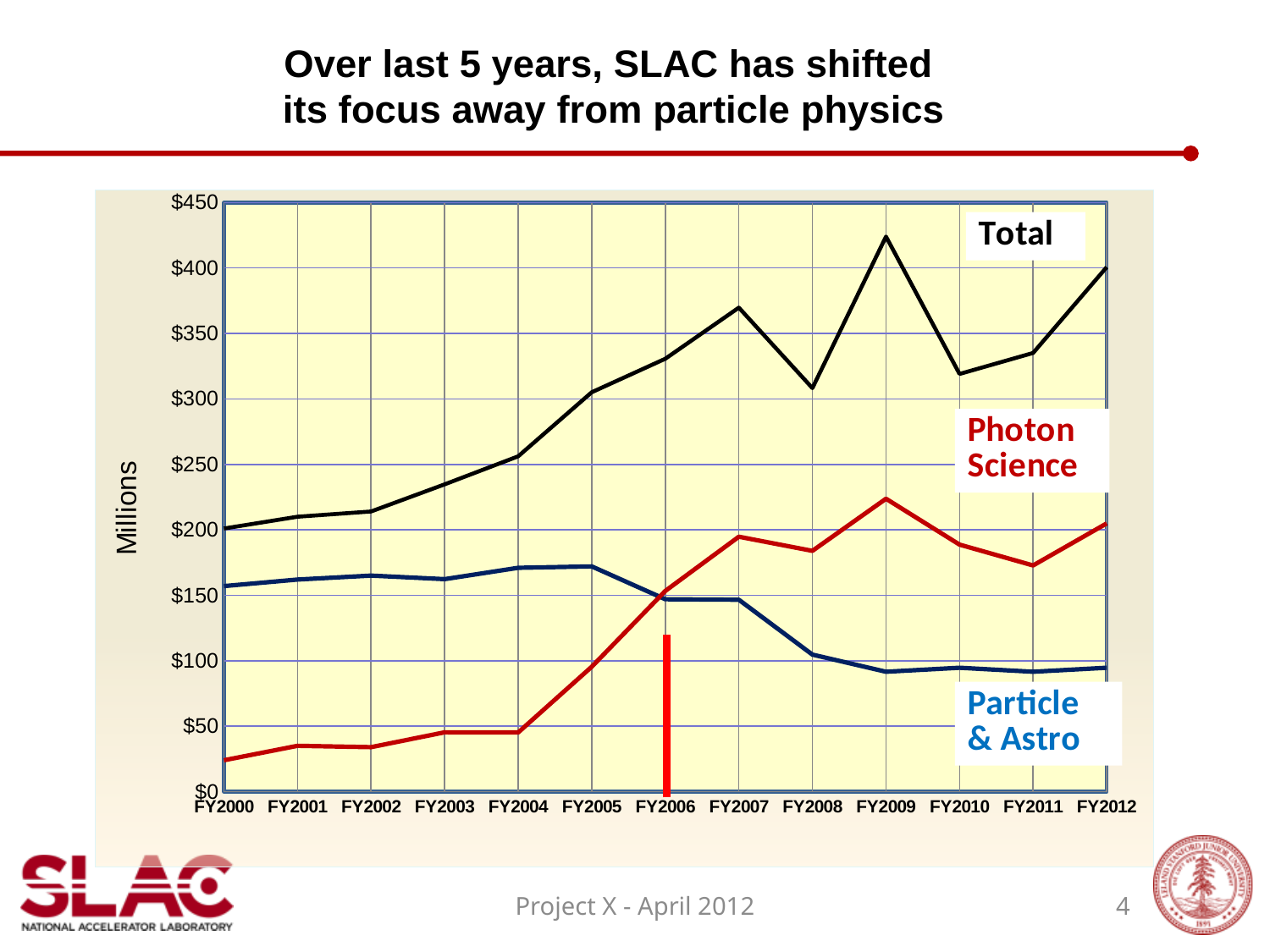
In which fiscal year is the Photon Science series at its lowest? FY2000 In which fiscal year is the Total series at its lowest? FY2000 Does the Particle & Astro series rise or fall from FY2005 to FY2009? Fall Is the Total value for FY2007 greater or less than $350? greater What kind of chart is shown on the slide? Line chart Is the Total value for FY2009 greater or less than $400? greater In FY2000, which is larger: Particle & Astro or Photon Science? Particle & Astro How many fiscal years are plotted along the x axis? 13 In FY2012, which is larger: Photon Science or Particle & Astro? Photon Science In which fiscal year does the Total series reach its highest value? FY2009 Is the Particle & Astro value for FY2012 greater or less than $100? less How many data series are plotted on the chart? 3